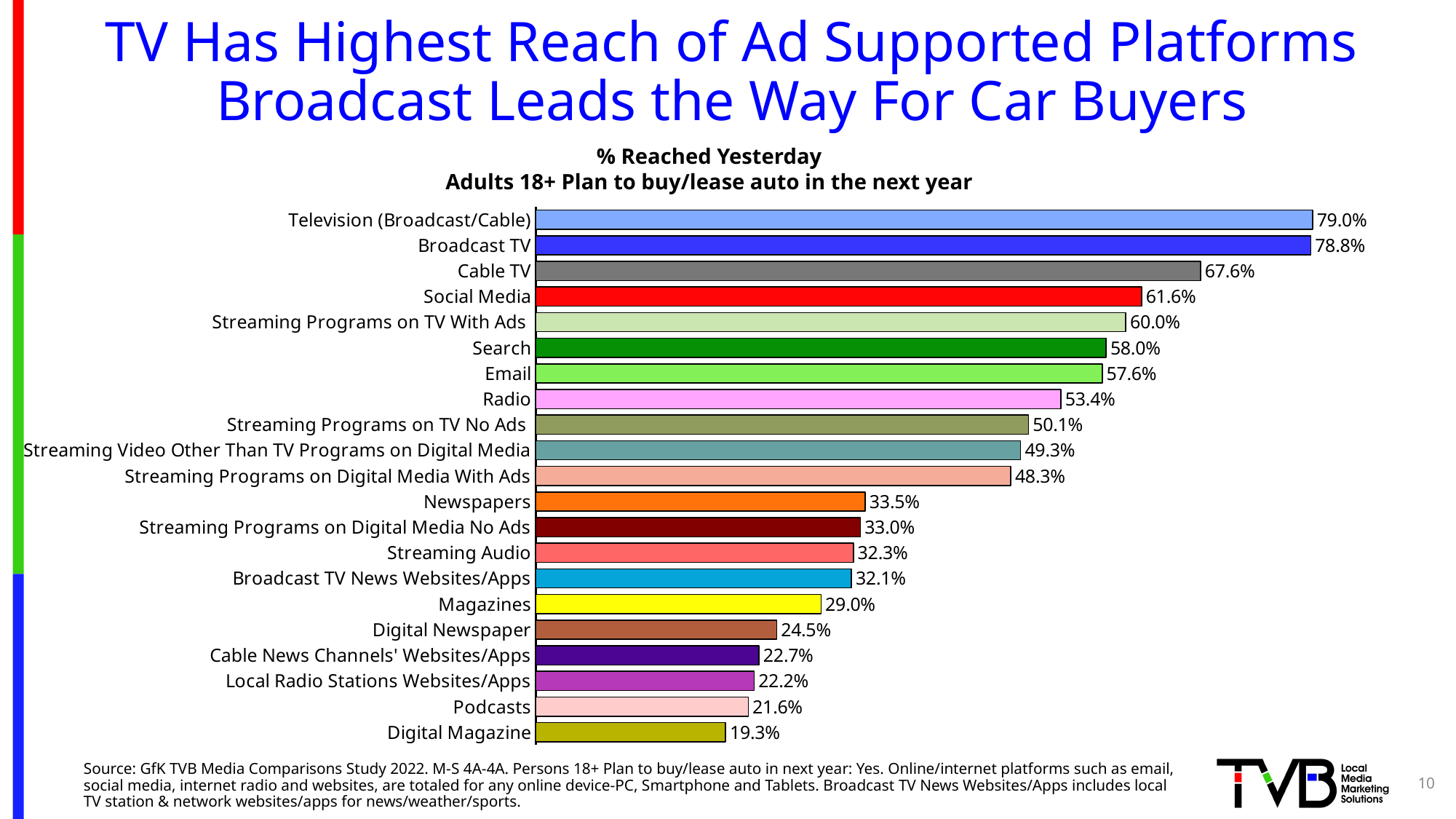
What is the value for Streaming Programs on TV With Ads? 60.0% How many categories are shown in the chart? 21 Which category has the lowest value? Digital Magazine What is the difference between the values for Radio and Podcasts? 31.8 percentage points What is the value for Radio? 53.4% What is the difference between the values for Broadcast TV and Cable TV? 11.2 percentage points What kind of chart is shown on the slide? Bar chart What is the value for Cable News Channels' Websites/Apps? 22.7% What is the title of the chart? % Reached Yesterday Adults 18+ Plan to buy/lease auto in the next year Which is larger, the value for Search or the value for Social Media? Social Media Which category has the highest value? Television (Broadcast/Cable) Which is larger, the value for Newspapers or the value for Magazines? Newspapers